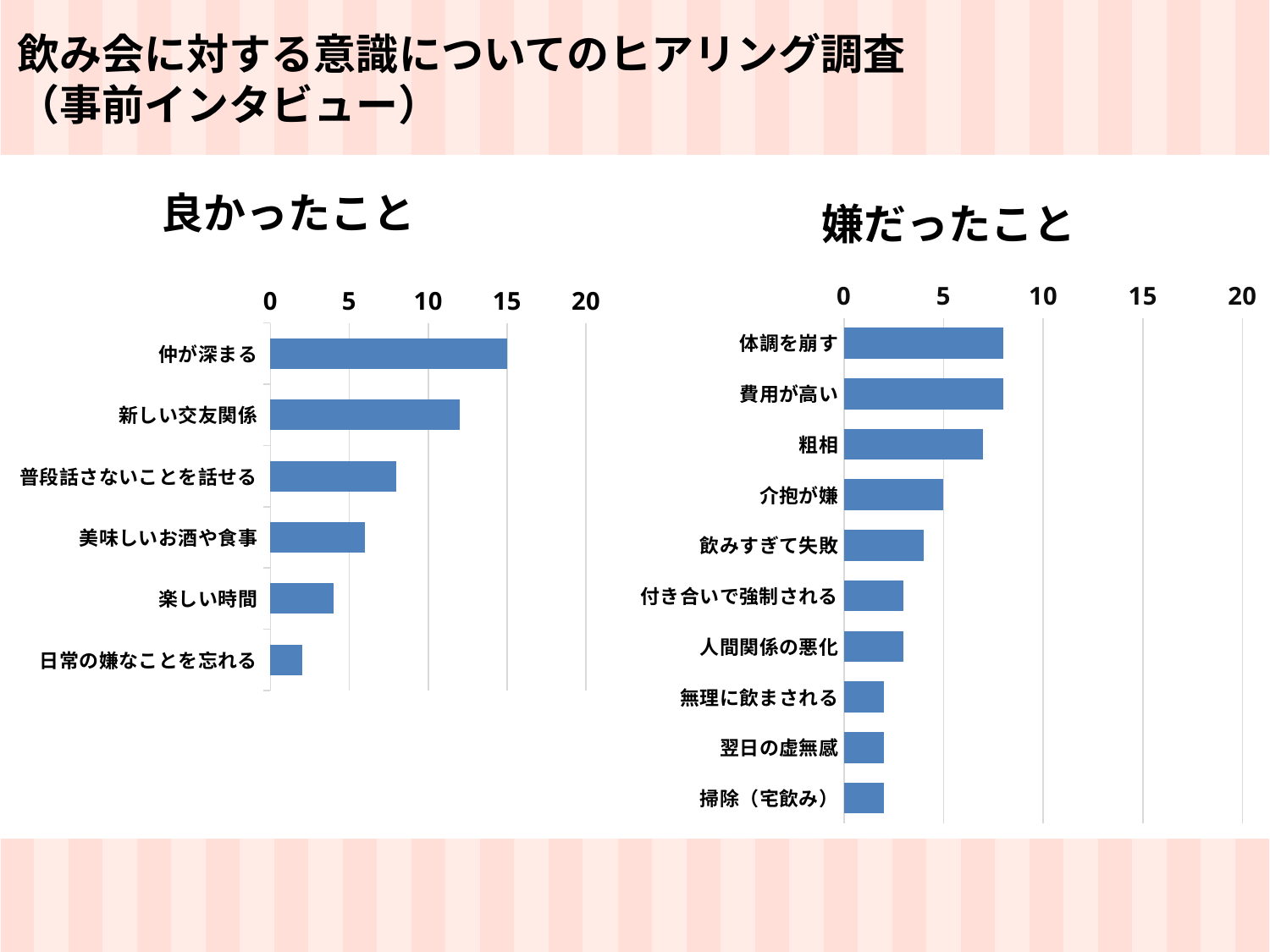
What is the title of the chart on the right side of the slide? 嫌だったこと In the 良かったこと chart, is the value for 新しい交友関係 greater or less than 10? greater How many categories does the 良かったこと chart show? 6 What kind of chart is the 良かったこと chart? bar chart In the 良かったこと chart, what is the value for 仲が深まる? 15 In the 嫌だったこと chart, what is the value for 介抱が嫌? 5 In the 嫌だったこと chart, is the value for 粗相 greater or less than 5? greater In the 良かったこと chart, which category has the lowest value? 日常の嫌なことを忘れる How many categories does the 嫌だったこと chart show? 10 In the 嫌だったこと chart, which is larger, 粗相 or 飲みすぎて失敗? 粗相 In the 良かったこと chart, which category has the highest value? 仲が深まる In the 良かったこと chart, is the value for 普段話さないことを話せる greater or less than 10? less